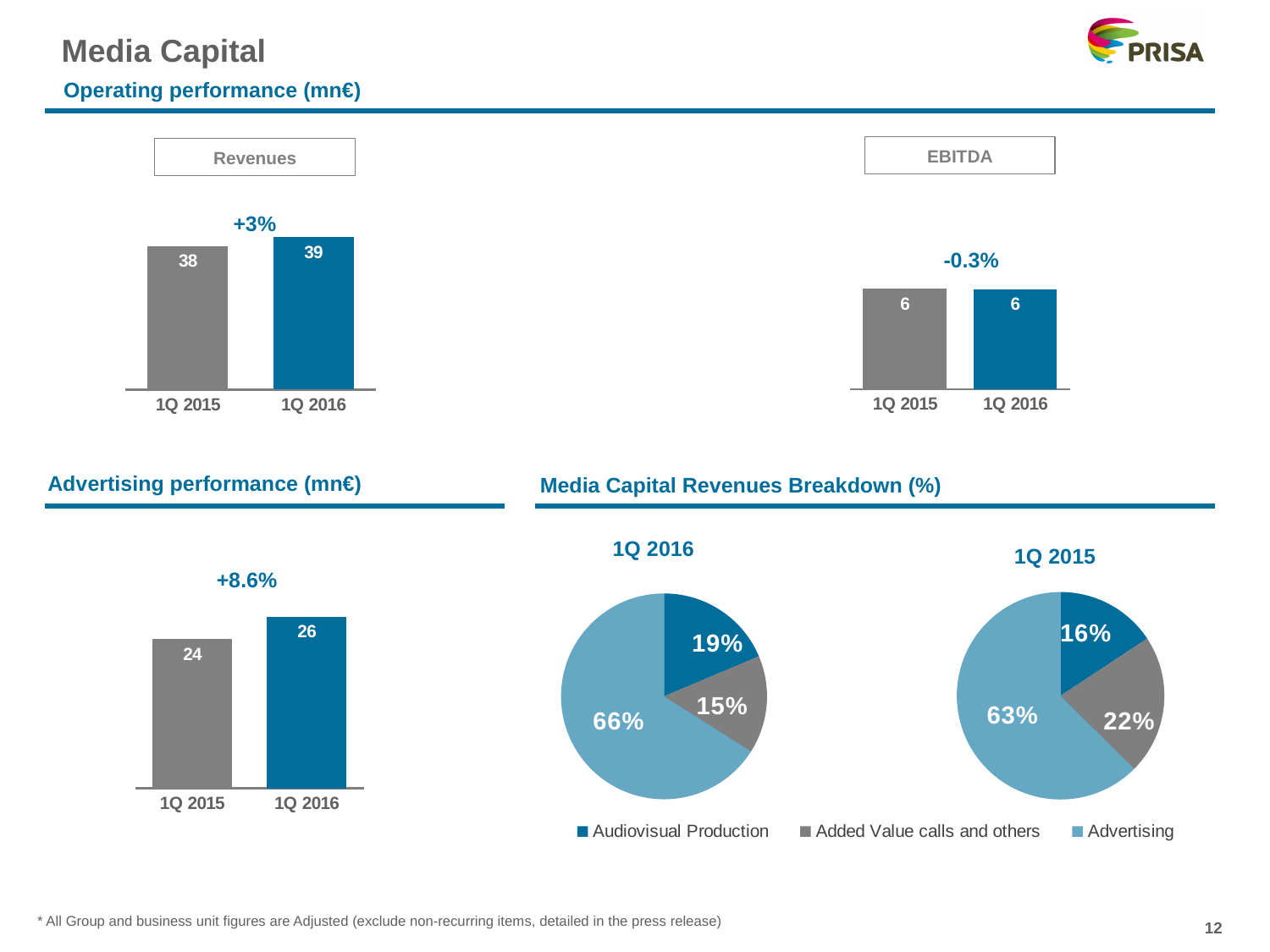
In the Advertising performance bar chart, what is the difference between 1Q 2016 and 1Q 2015? 2 In the Advertising performance bar chart, what is the value for 1Q 2016? 26 In the Revenues bar chart, what is the difference between 1Q 2016 and 1Q 2015? 1 How many categories does the legend of the Media Capital Revenues Breakdown pie charts list? 3 In the EBITDA bar chart, what percentage change is shown above the bars? -0.3% In the EBITDA bar chart, what is the value for 1Q 2015? 6 In the Advertising performance bar chart, which period has the higher value? 1Q 2016 In the Revenues bar chart, what is the value for 1Q 2015? 38 In the 1Q 2015 Media Capital Revenues Breakdown pie chart, what share does Added Value calls and others have? 22% In the Revenues bar chart, what is the value for 1Q 2016? 39 In the 1Q 2016 Media Capital Revenues Breakdown pie chart, which category has the smallest share? Added Value calls and others In the 1Q 2016 Media Capital Revenues Breakdown pie chart, what share does Advertising have? 66%